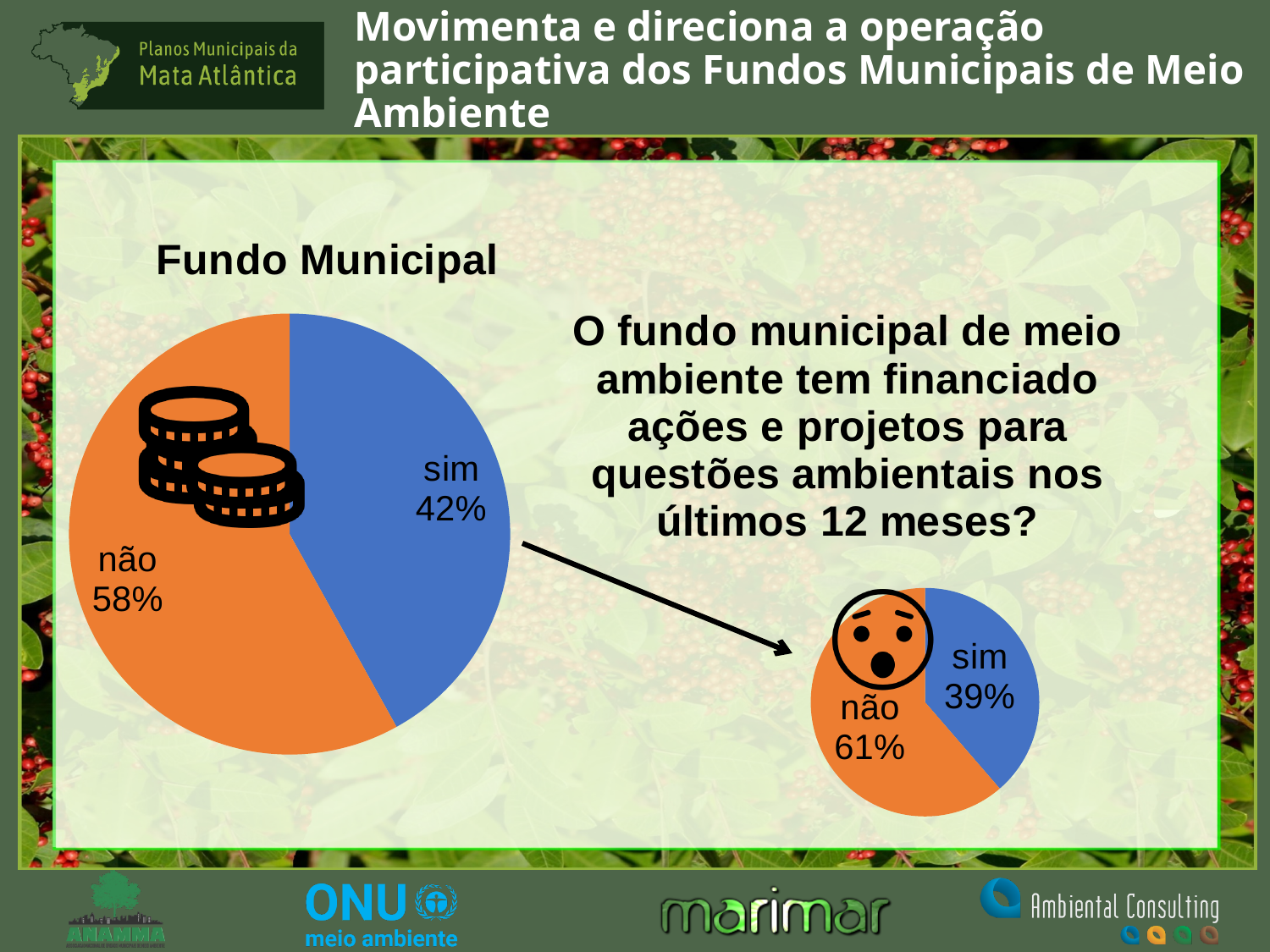
In the "Fundo Municipal" pie chart on the left, what is the share for "não"? 58% In the "Fundo Municipal" pie chart on the left, which slice is the largest? não In the smaller pie chart at the bottom right, what is the difference between the "não" and "sim" shares? 22% What type of chart is the "Fundo Municipal" chart on the left? Pie chart Is the "sim" share larger in the "Fundo Municipal" pie chart on the left or in the smaller pie chart at the bottom right? Fundo Municipal pie chart on the left In the smaller pie chart at the bottom right, what is the share for "sim"? 39% In the "Fundo Municipal" pie chart on the left, what is the share for "sim"? 42% In the smaller pie chart at the bottom right, what is the share for "não"? 61% In the "Fundo Municipal" pie chart on the left, what is the difference between the "não" and "sim" shares? 16% In the smaller pie chart at the bottom right, which slice is the smallest? sim How many slices does the smaller pie chart at the bottom right have? 2 In the "Fundo Municipal" pie chart on the left, what colour is the "sim" slice? Blue